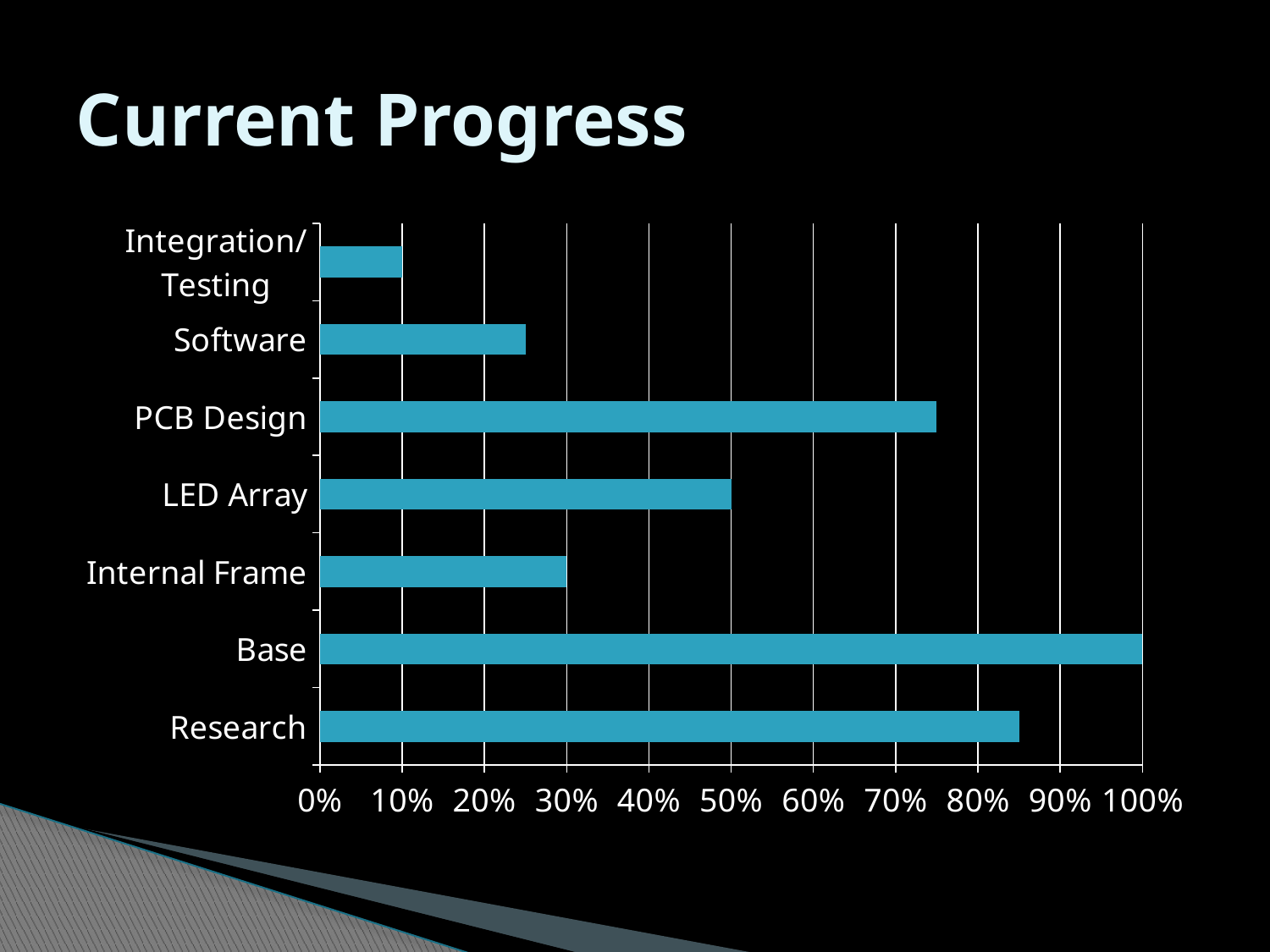
What is the value for LED Array? 50% What is the title of the chart? Current Progress Which is larger, the value for PCB Design or the value for LED Array? PCB Design What is the value for Integration/Testing? 10% What type of chart is shown on the slide? bar chart Which category has the highest value? Base Is the value for Software greater or less than 20%? greater Which category has the lowest value? Integration/Testing What is the value for Base? 100% What is the difference between the values for Base and Internal Frame? 70% What is the value for Internal Frame? 30% How many categories are shown in the chart? 7